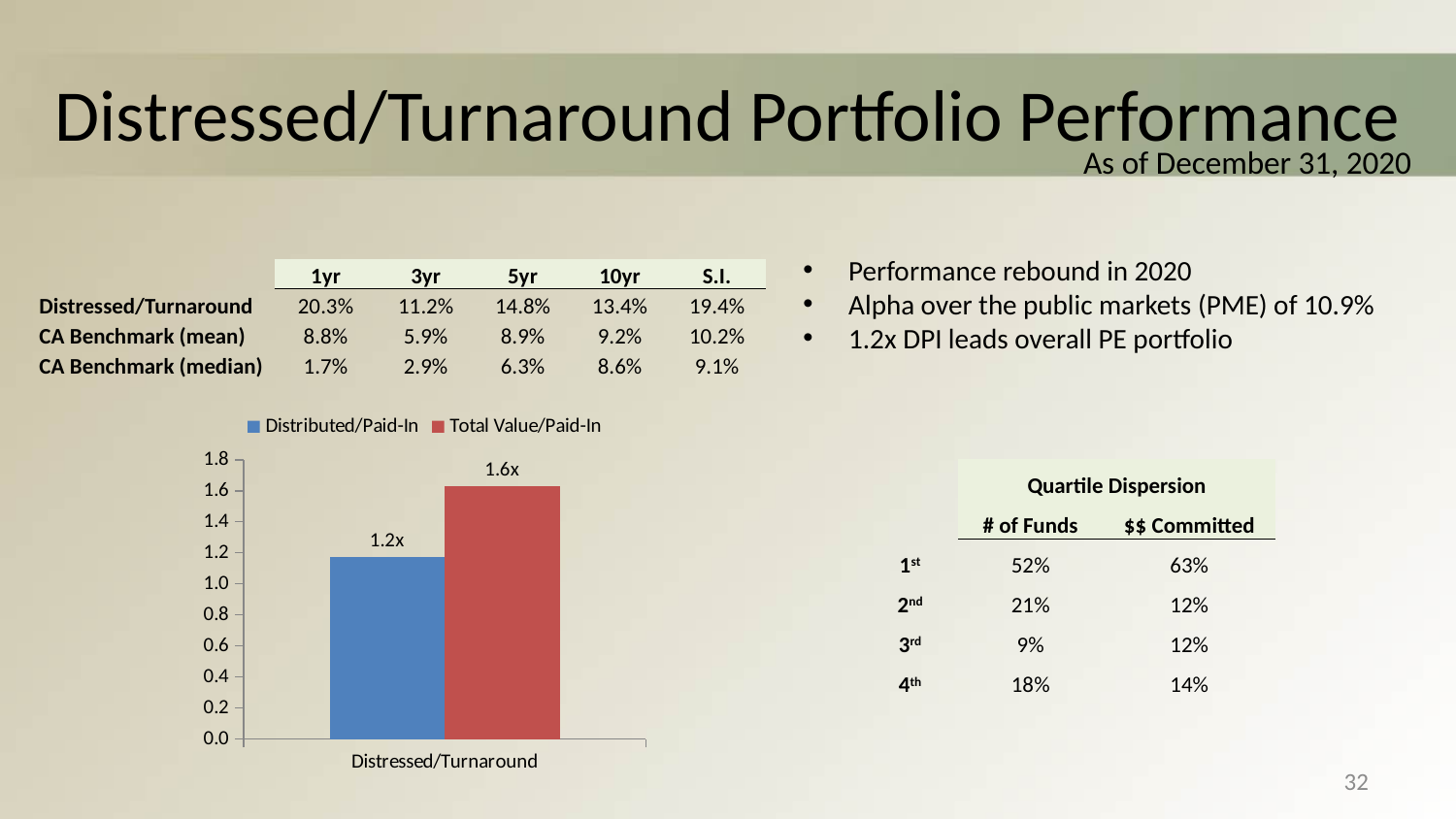
What is the Total Value/Paid-In value for Distressed/Turnaround in the bar chart? 1.6x What is the Distributed/Paid-In value for Distressed/Turnaround in the bar chart? 1.2x What is the category label on the x axis of the bar chart? Distressed/Turnaround What colour represents Total Value/Paid-In in the bar chart? Red What kind of chart is shown on the slide? Bar chart Is the Distributed/Paid-In value in the bar chart greater or less than 1.0? greater What is the difference between the Total Value/Paid-In and Distributed/Paid-In values in the bar chart? 0.4x Which series shows the lowest value in the bar chart? Distributed/Paid-In How many categories are shown on the x axis of the bar chart? 1 How many series does the legend of the bar chart list? 2 Which series has the higher value in the bar chart, Distributed/Paid-In or Total Value/Paid-In? Total Value/Paid-In Is the Total Value/Paid-In value in the bar chart greater or less than 1.4? greater